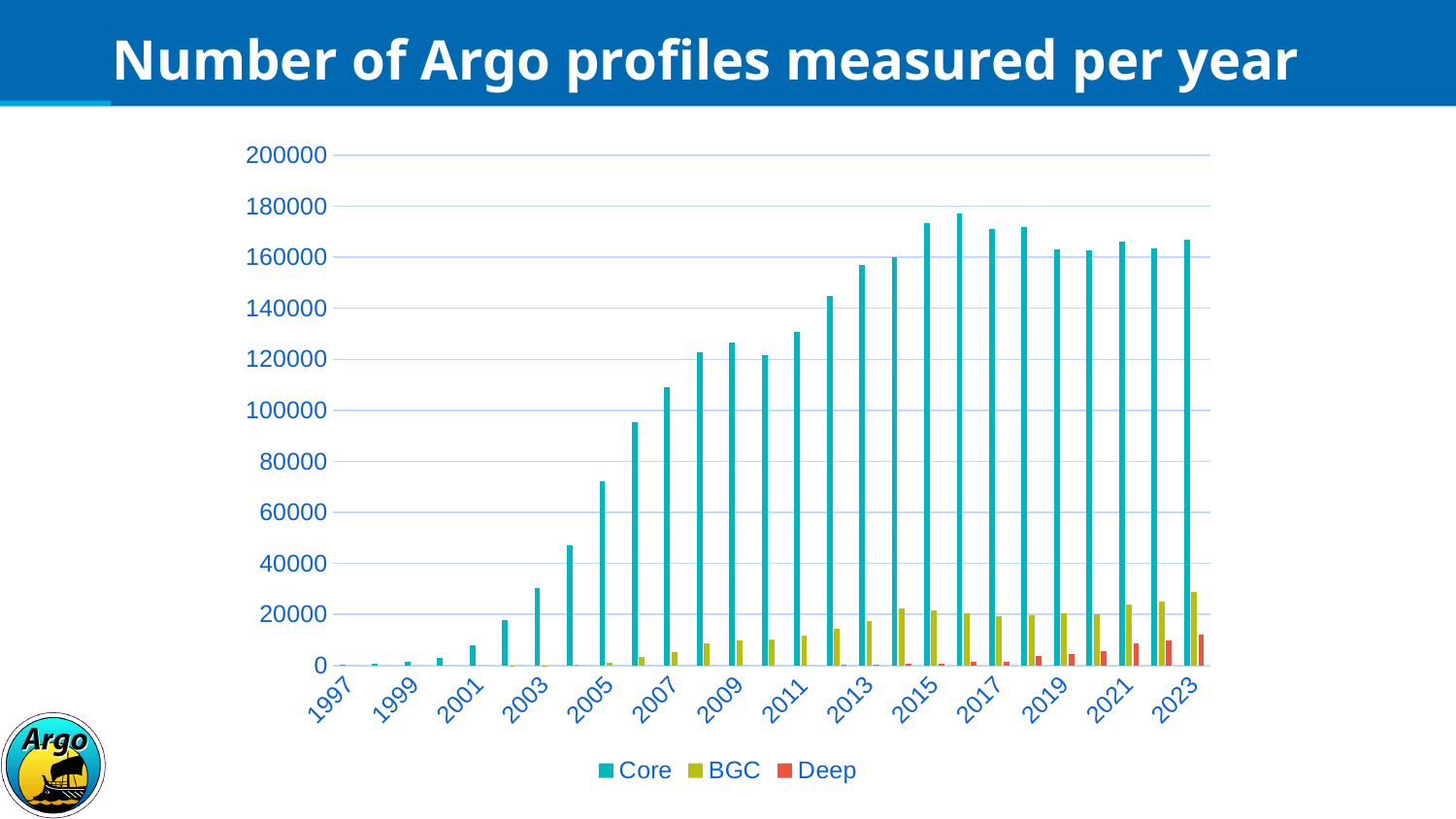
What kind of chart is shown on the slide? bar chart How many series does the legend list? 3 Is the BGC value for 2023 greater or less than 20000? greater Is the Core value for 2005 greater or less than 80000? less Is the Deep value for 2023 greater or less than 20000? less Which year has the lowest Core value? 1997 What is the title of the chart? Number of Argo profiles measured per year Which is larger, the Core value for 2016 or the Core value for 2023? 2016 Do the Core values rise or fall from 1997 to 2016? rise Which year has the highest Core value? 2016